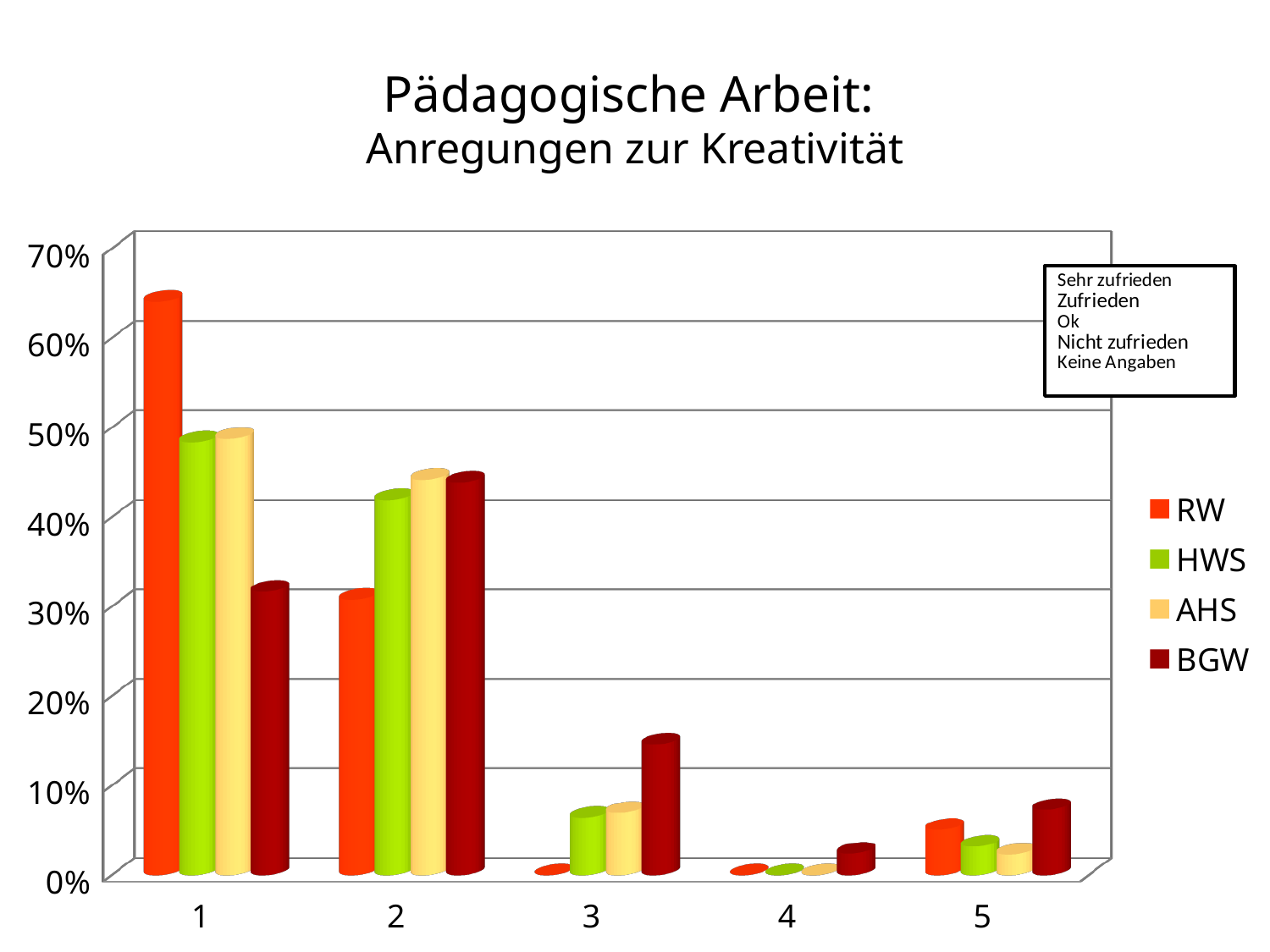
Is the value for BGW in category 1 greater or less than 40%? less What is the title of the chart? Pädagogische Arbeit: Anregungen zur Kreativität Which series has the highest value in category 3? BGW How many series does the legend list? 4 Which series has the lowest value in category 1? BGW Is the value for RW in category 2 greater or less than 40%? less What kind of chart is shown on the slide? bar chart Is the value for RW in category 1 greater or less than 60%? greater Which is larger in category 2: the value for RW or the value for HWS? HWS How many categories are shown on the x axis? 5 Which series has the highest value in category 1? RW Which is larger in category 1: the value for RW or the value for BGW? RW